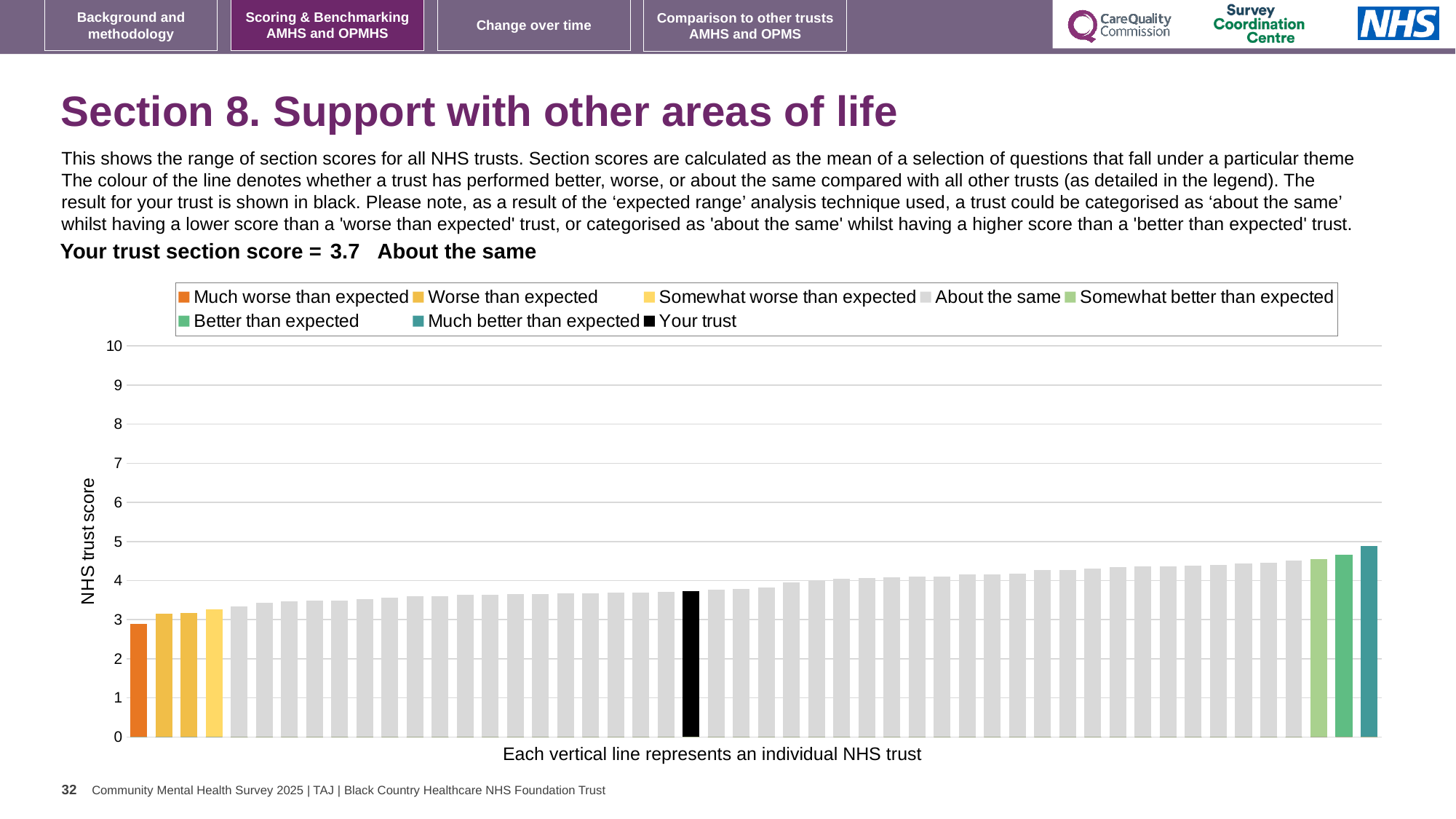
Is the value of the black 'Your trust' bar greater or less than 3? greater What kind of chart is shown on the slide? bar chart What is the label on the vertical axis of the chart? NHS trust score What is the section score for your trust shown on the slide? 3.7 Is the value of the black 'Your trust' bar greater or less than 4? less How many bars are coloured orange (Much worse than expected)? 1 Which legend category does the shortest bar on the chart belong to? Much worse than expected How many entries does the chart legend list? 8 Is the value of the tallest bar (Much better than expected) greater or less than 4? greater Which legend category does the tallest bar on the chart belong to? Much better than expected Do the bar values rise or fall from left to right along the x axis? rise